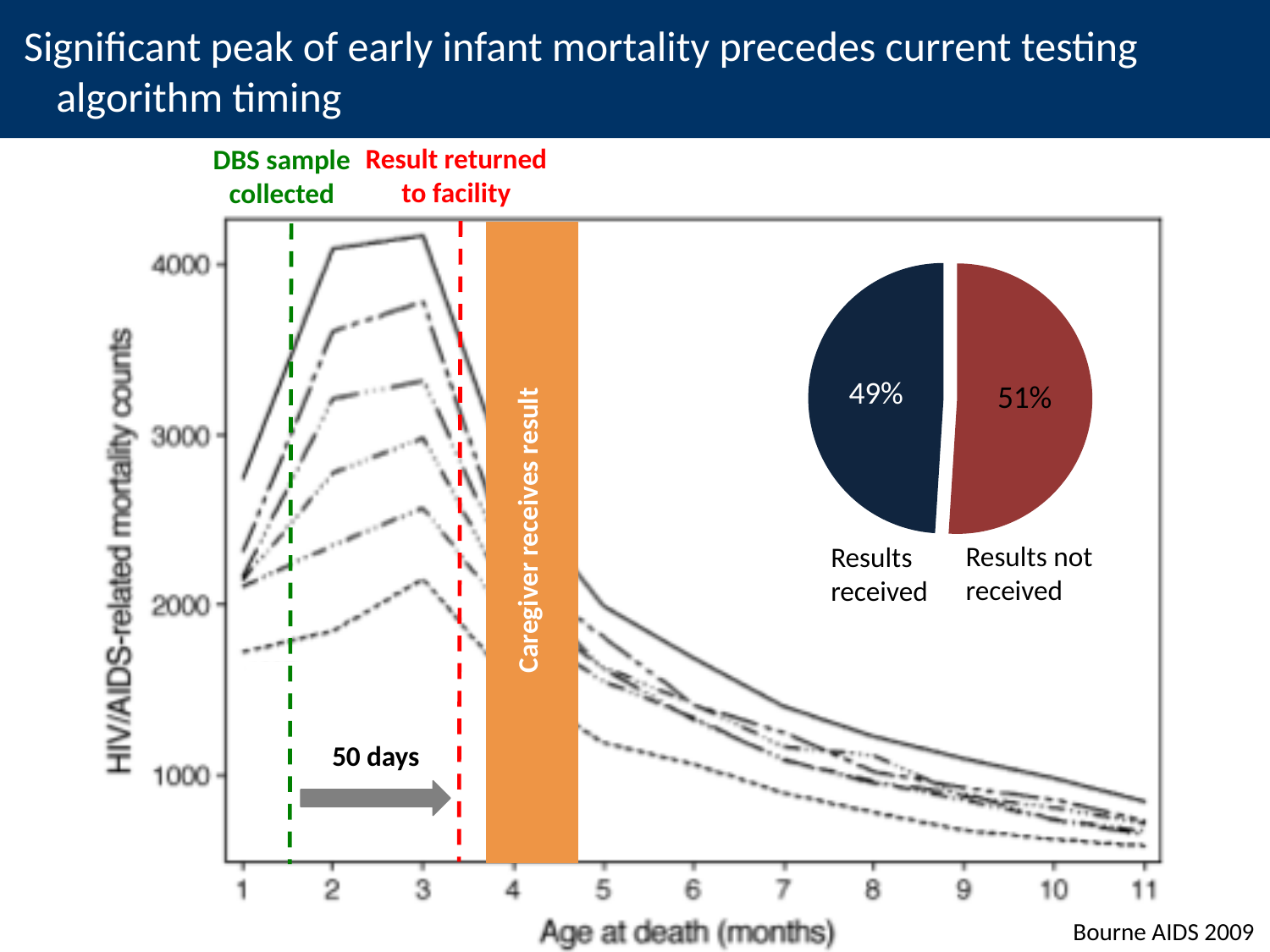
In the line chart, what does the orange shaded band represent? Caregiver receives result How many slices does the pie chart have? 2 In the line chart, is the peak value of the topmost line at month 3 greater or less than 4000? greater In the line chart, what is the label of the x axis? Age at death (months) In the pie chart, which slice is larger, 'Results received' or 'Results not received'? Results not received In the line chart, do the mortality counts rise or fall between month 3 and month 11 on the x axis? Fall In the pie chart, what percentage is shown for 'Results not received'? 51% What kind of chart is the chart on the right side of the slide? Pie chart In the pie chart, what percentage is shown for 'Results received'? 49% In the pie chart, what is the difference in percentage points between 'Results not received' and 'Results received'? 2 In the line chart, is the value of the topmost line at month 11 greater or less than 1000? less What kind of chart is the large chart on the left showing HIV/AIDS-related mortality counts? Line chart